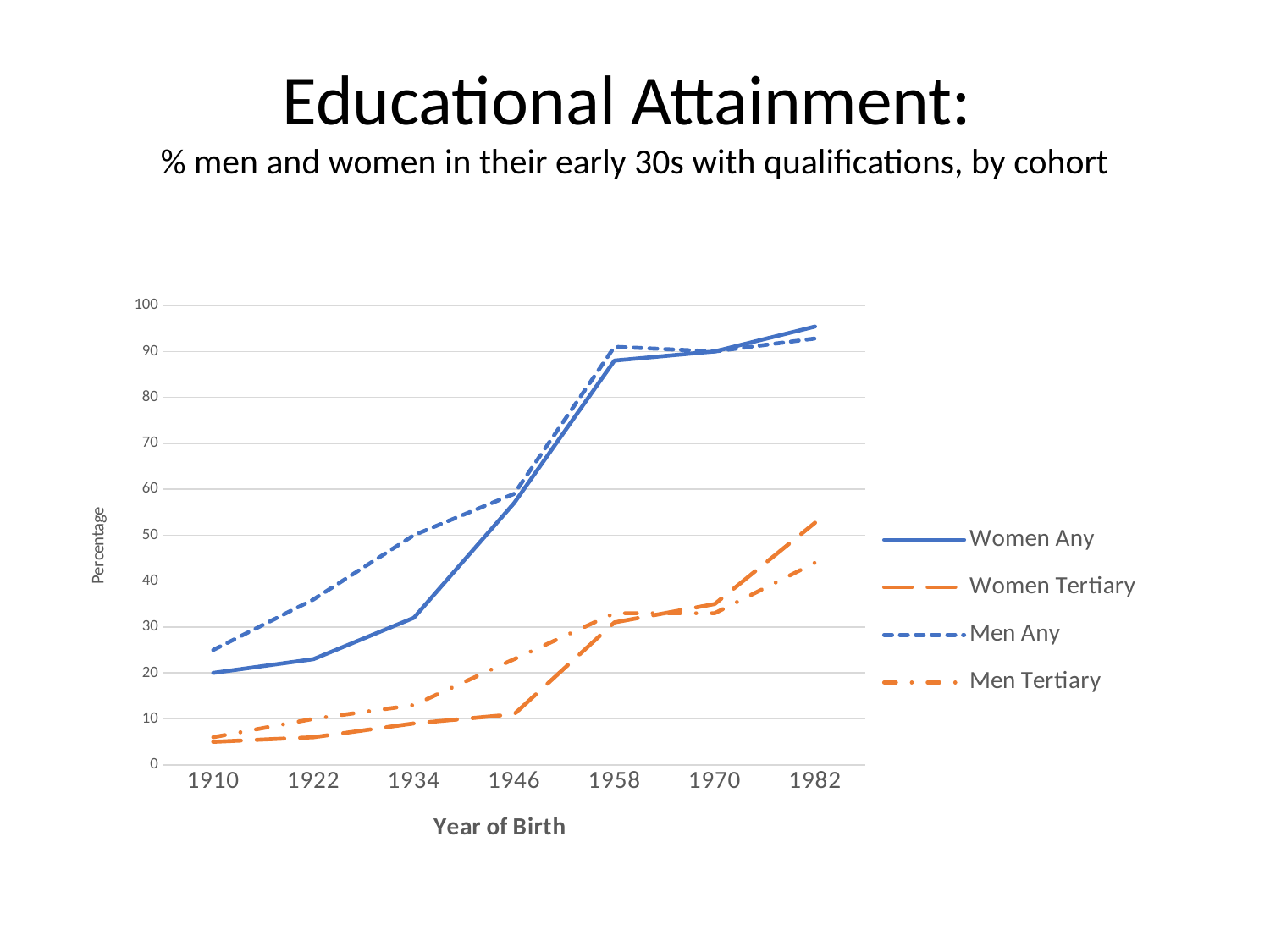
Is the value for Women Any in 1982 greater or less than 90? greater What kind of chart is shown on the slide? line chart In 1982, which is larger: Women Tertiary or Men Tertiary? Women Tertiary Which series has the lowest value in 1946? Women Tertiary How many birth-year cohorts are plotted along the x axis? 7 Is the value for Men Any in 1934 greater or less than 40? greater Is the value for Men Tertiary in 1970 greater or less than 40? less Does the Women Any series rise or fall from 1910 to 1982? rise How many series does the legend list? 4 In 1934, which is larger: Men Any or Women Any? Men Any